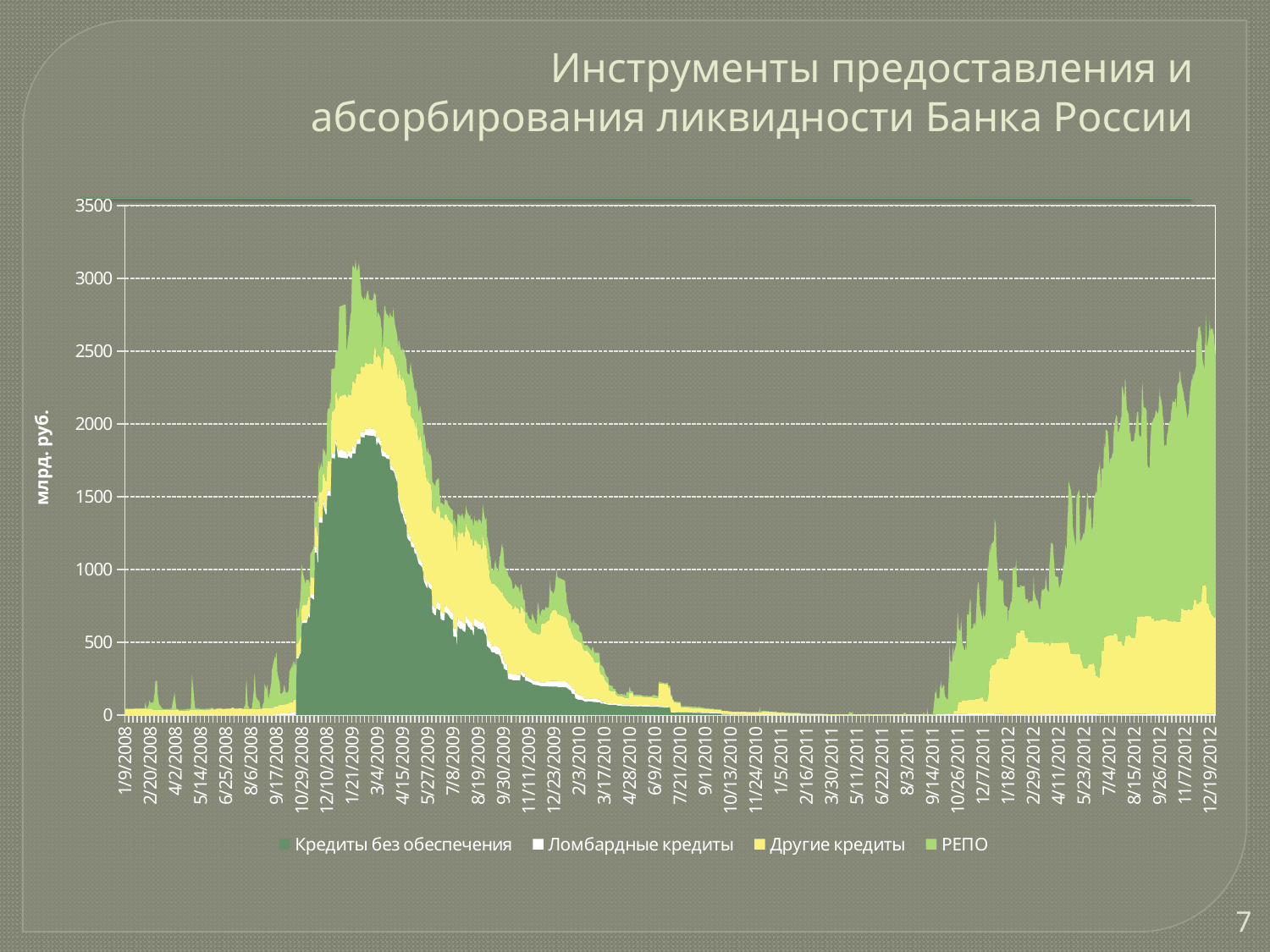
How many series does the legend list? 4 Is the total stacked value at 12/19/2012 greater or less than 2000? greater Does the total stacked value rise or fall between 9/14/2011 and 12/19/2012? rise What are the series names listed in the legend? Кредиты без обеспечения, Ломбардные кредиты, Другие кредиты, РЕПО Is the total stacked value around 9/30/2009 greater or less than 1500? less Is the total stacked value around 1/21/2009 greater or less than 2500? greater What unit is shown on the vertical axis label? млрд. руб. What kind of chart is shown on the slide? area chart Which series is larger at the end of 2012, РЕПО or Другие кредиты? РЕПО Which series is larger around 1/21/2009, Кредиты без обеспечения or Другие кредиты? Кредиты без обеспечения Does the total stacked value rise or fall between 3/4/2009 and 9/1/2010? fall